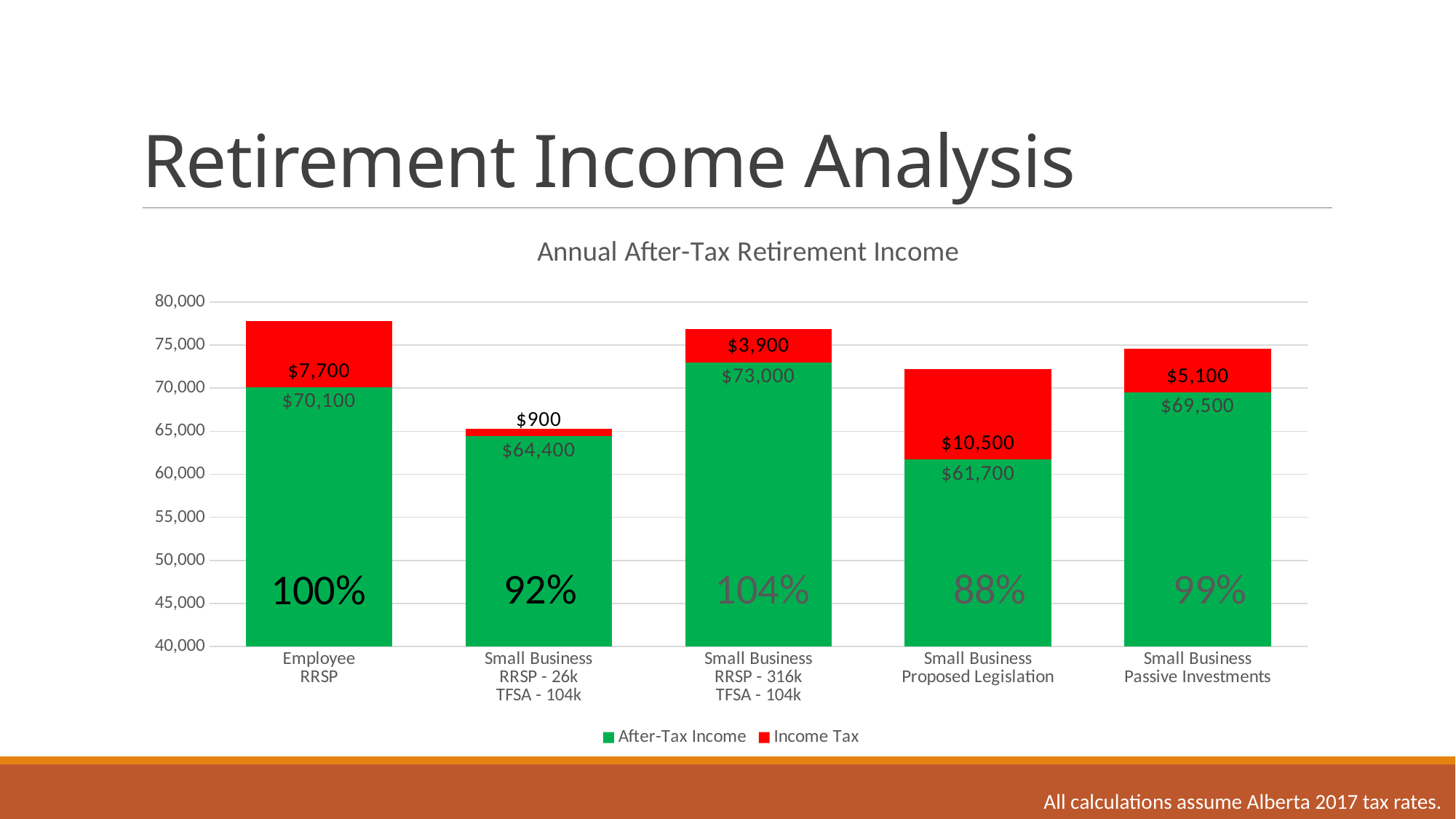
What is the After-Tax Income for Small Business Passive Investments? $69,500 What is the total of the stacked bar for Small Business Proposed Legislation? $72,200 What is the After-Tax Income for Employee RRSP? $70,100 What is the difference in Income Tax between Employee RRSP and Small Business Passive Investments? $2,600 Which category has the lowest Income Tax? Small Business RRSP - 26k TFSA - 104k What kind of chart is shown? Stacked bar chart Which is larger, the After-Tax Income for Employee RRSP or for Small Business Proposed Legislation? Employee RRSP Which category has the highest After-Tax Income? Small Business RRSP - 316k TFSA - 104k How many series does the legend list? 2 What percentage is printed on the bar for Small Business Proposed Legislation? 88% What is the Income Tax for Small Business Proposed Legislation? $10,500 How many categories are shown on the x axis? 5